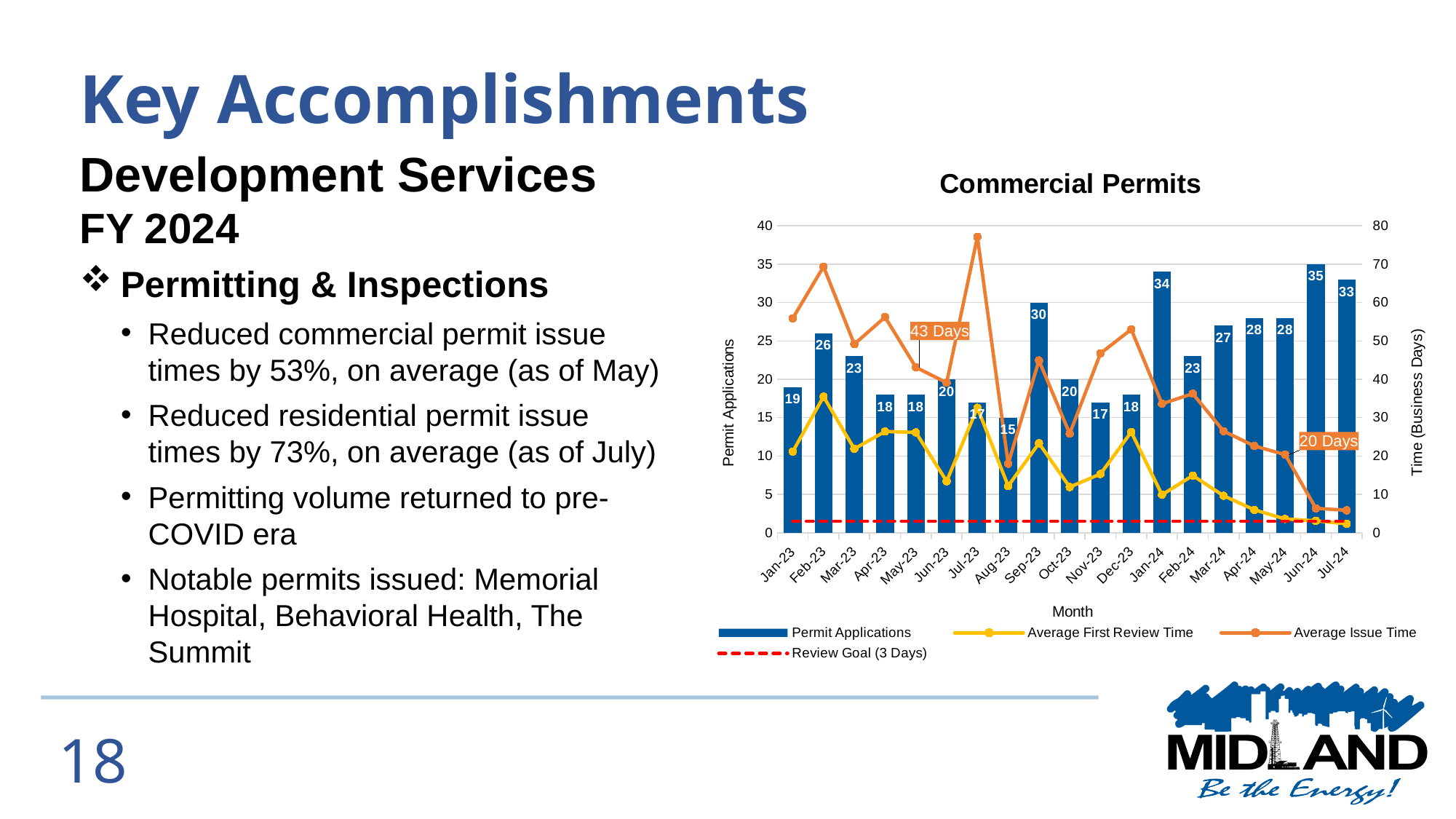
In the Commercial Permits chart, how many permit applications were there in Jan-24? 34 In the Commercial Permits chart, what is the difference in permit applications between Jun-24 and Aug-23? 20 In the Commercial Permits chart, what Average Issue Time is annotated for May-23? 43 Days In the Commercial Permits chart, how many permit applications were there in Sep-23? 30 In the Commercial Permits chart, is the Average Issue Time for Jul-23 greater or less than 70 business days? greater What kind of chart is the Commercial Permits chart? Combined bar and line chart How many series does the legend of the Commercial Permits chart list? 4 In the Commercial Permits chart, which month had the highest number of permit applications? Jun-24 In the Commercial Permits chart, which month had the lowest number of permit applications? Aug-23 In the Commercial Permits chart, does the Average Issue Time rise or fall from Jan-24 to Jul-24? fall How many months are shown on the x axis of the Commercial Permits chart? 19 In the Commercial Permits chart, which month had more permit applications, Sep-23 or Jan-24? Jan-24